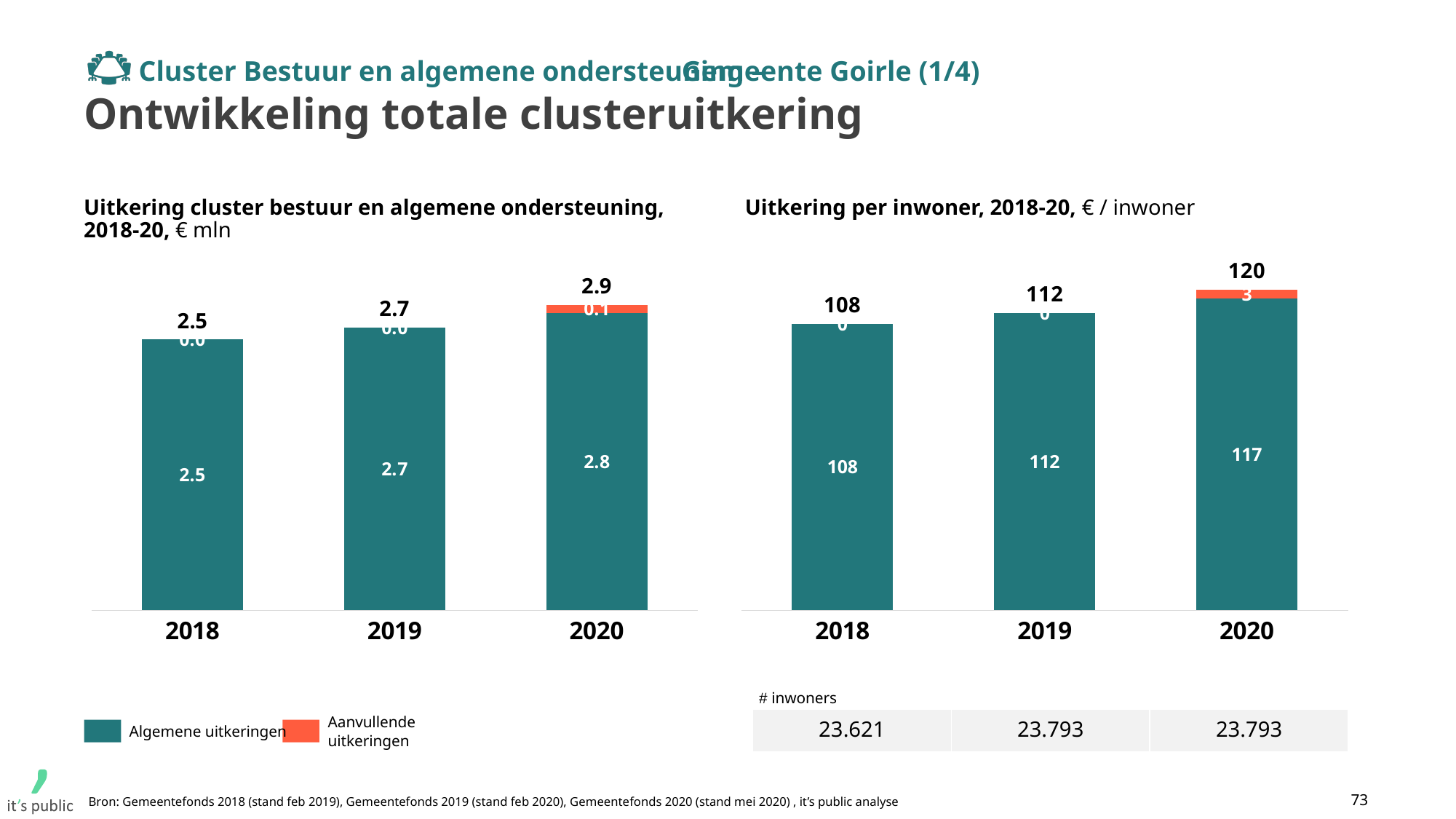
In the right chart (Uitkering per inwoner), what is the difference between the 2019 total and the 2018 total? 4 In the left chart (Uitkering cluster bestuur en algemene ondersteuning), what is the value of Aanvullende uitkeringen in 2020? 0.1 In the left chart (Uitkering cluster bestuur en algemene ondersteuning), what is the value of Algemene uitkeringen in 2019? 2.7 In the left chart (Uitkering cluster bestuur en algemene ondersteuning), which year has the lowest total? 2018 What kind of chart is the left chart (Uitkering cluster bestuur en algemene ondersteuning)? stacked bar chart In the right chart (Uitkering per inwoner), what is the value of Aanvullende uitkeringen in 2020? 3 How many series does the legend list? 2 In the right chart (Uitkering per inwoner), what is the total value for 2020? 120 In the left chart (Uitkering cluster bestuur en algemene ondersteuning), what is the total value for 2020? 2.9 In the right chart (Uitkering per inwoner), do the totals rise or fall from 2018 to 2020? rise In the right chart (Uitkering per inwoner), what is the value of Algemene uitkeringen in 2020? 117 In the left chart (Uitkering cluster bestuur en algemene ondersteuning), what is the difference between the 2020 total and the 2018 total? 0.4